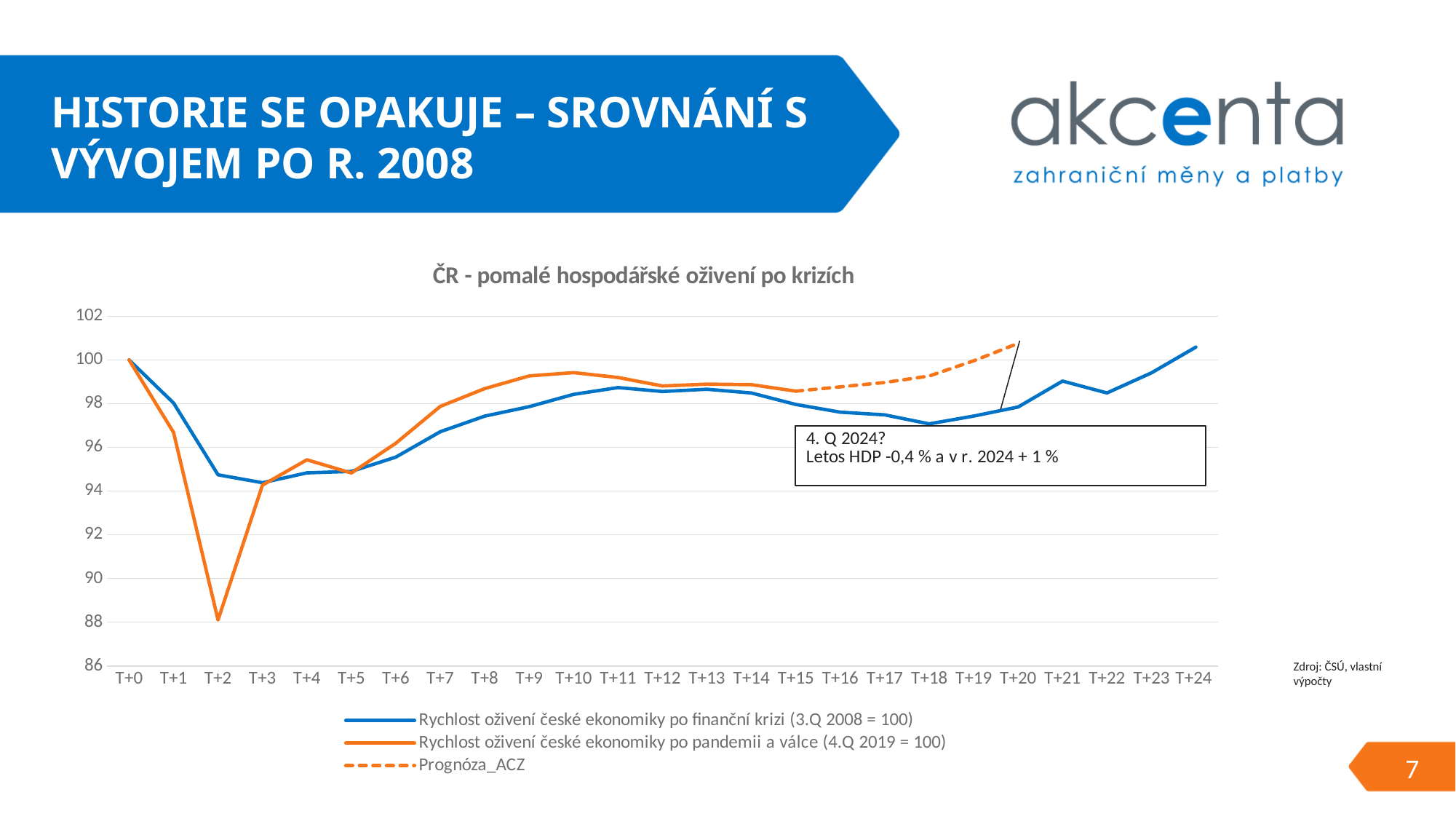
At T+9, which series has the higher value: the one after the financial crisis (3.Q 2008 = 100) or the one after the pandemic and war (4.Q 2019 = 100)? Rychlost oživení české ekonomiky po pandemii a válce (4.Q 2019 = 100) How many points are on the x axis (from T+0 to T+24)? 25 What is the value of the series 'Rychlost oživení české ekonomiky po pandemii a válce (4.Q 2019 = 100)' at T+0? 100 At T+2, which series has the higher value: the one after the financial crisis (3.Q 2008 = 100) or the one after the pandemic and war (4.Q 2019 = 100)? Rychlost oživení české ekonomiky po finanční krizi (3.Q 2008 = 100) Does the series 'Rychlost oživení české ekonomiky po finanční krizi (3.Q 2008 = 100)' rise or fall between T+18 and T+24? rise At which point on the x axis does the series 'Rychlost oživení české ekonomiky po pandemii a válce (4.Q 2019 = 100)' reach its lowest value? T+2 How many series does the legend list? 3 Which legend entry is drawn as a dashed line? Prognóza_ACZ Is the value of the series 'Rychlost oživení české ekonomiky po finanční krizi (3.Q 2008 = 100)' at T+24 greater or less than 100? greater What is the title of the chart? ČR - pomalé hospodářské oživení po krizích Is the value of the series 'Rychlost oživení české ekonomiky po pandemii a válce (4.Q 2019 = 100)' at T+2 greater or less than 90? less What kind of chart is shown on the slide? line chart